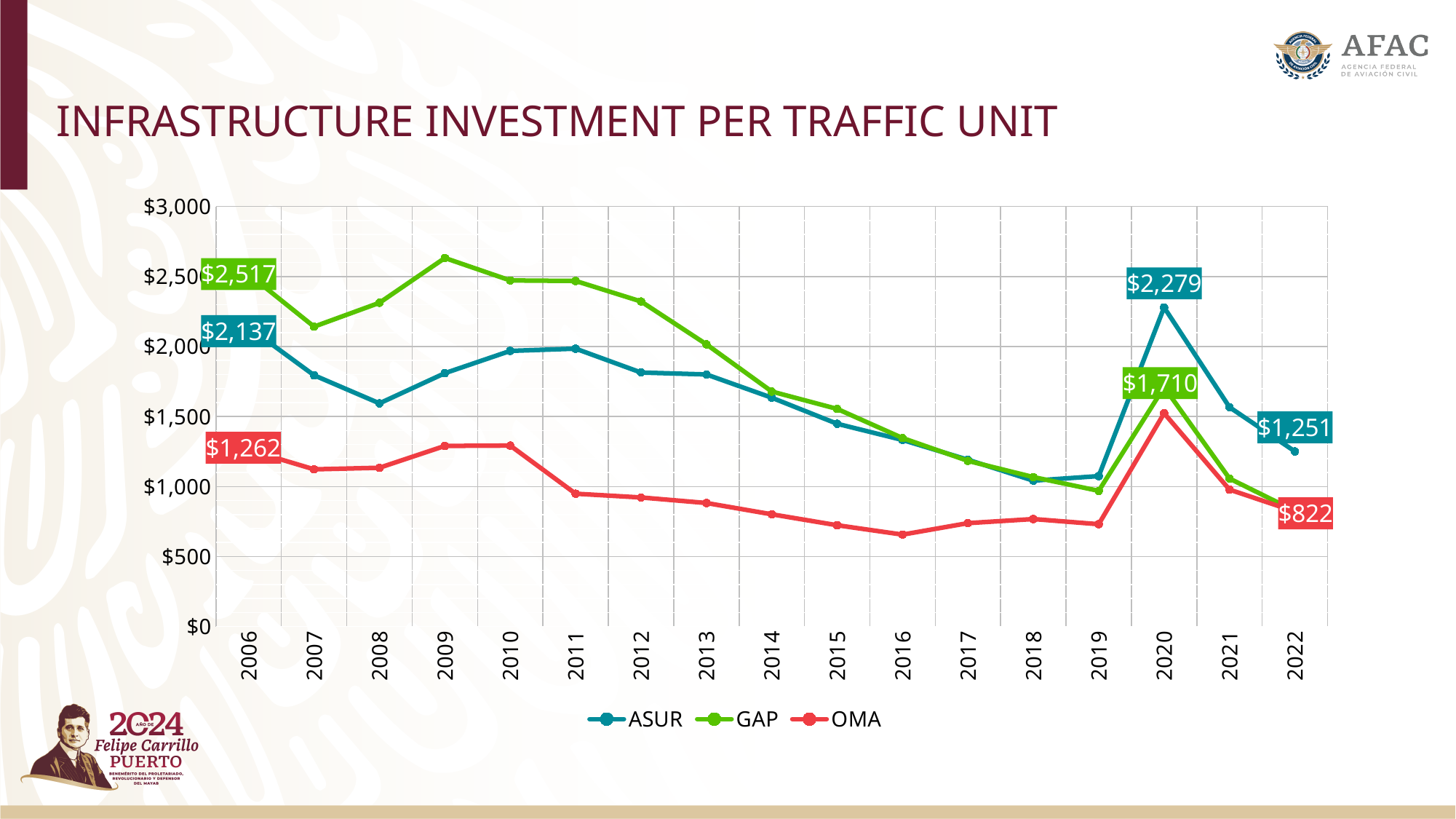
What is the difference between the ASUR value in 2006 and the ASUR value in 2022? $886 What is the value for ASUR in 2006? $2,137 How many years are shown on the x axis? 17 What is the value for OMA in 2006? $1,262 How many series does the legend list? 3 Which is larger in 2020, the ASUR value or the GAP value? ASUR What type of chart is shown on the slide? line chart What is the value for ASUR in 2020? $2,279 Which series has the highest value in 2006? GAP What is the value for OMA in 2022? $822 Is the value for OMA in 2016 greater or less than $1,000? less What is the value for GAP in 2006? $2,517